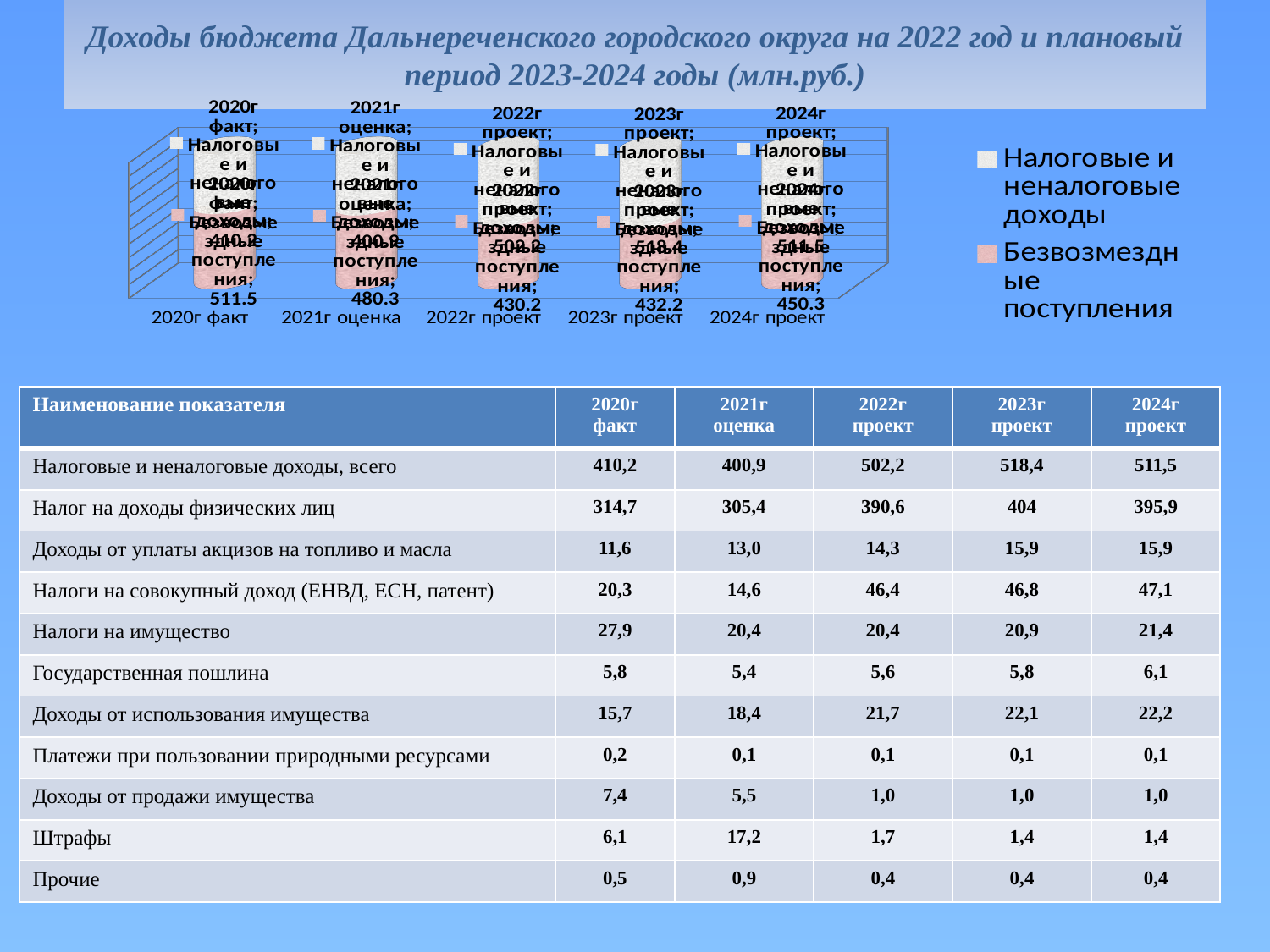
How many categories are shown along the x axis of the chart? 5 What is the value of Безвозмездные поступления for 2022г проект in the chart? 430.2 How many series does the chart legend list? 2 What is the value of Безвозмездные поступления for 2021г оценка in the chart? 480.3 Which series is shown in pink in the chart legend? Безвозмездные поступления In which category is the value of Безвозмездные поступления highest? 2020г факт What kind of chart is shown at the top of the slide? bar chart What is the difference between the Безвозмездные поступления values for 2020г факт and 2021г оценка? 31.2 Which is larger, the Безвозмездные поступления value for 2023г проект or for 2024г проект? 2024г проект In which category is the value of Безвозмездные поступления lowest? 2022г проект What is the value of Безвозмездные поступления for 2020г факт in the chart? 511.5 What is the value of Безвозмездные поступления for 2024г проект in the chart? 450.3